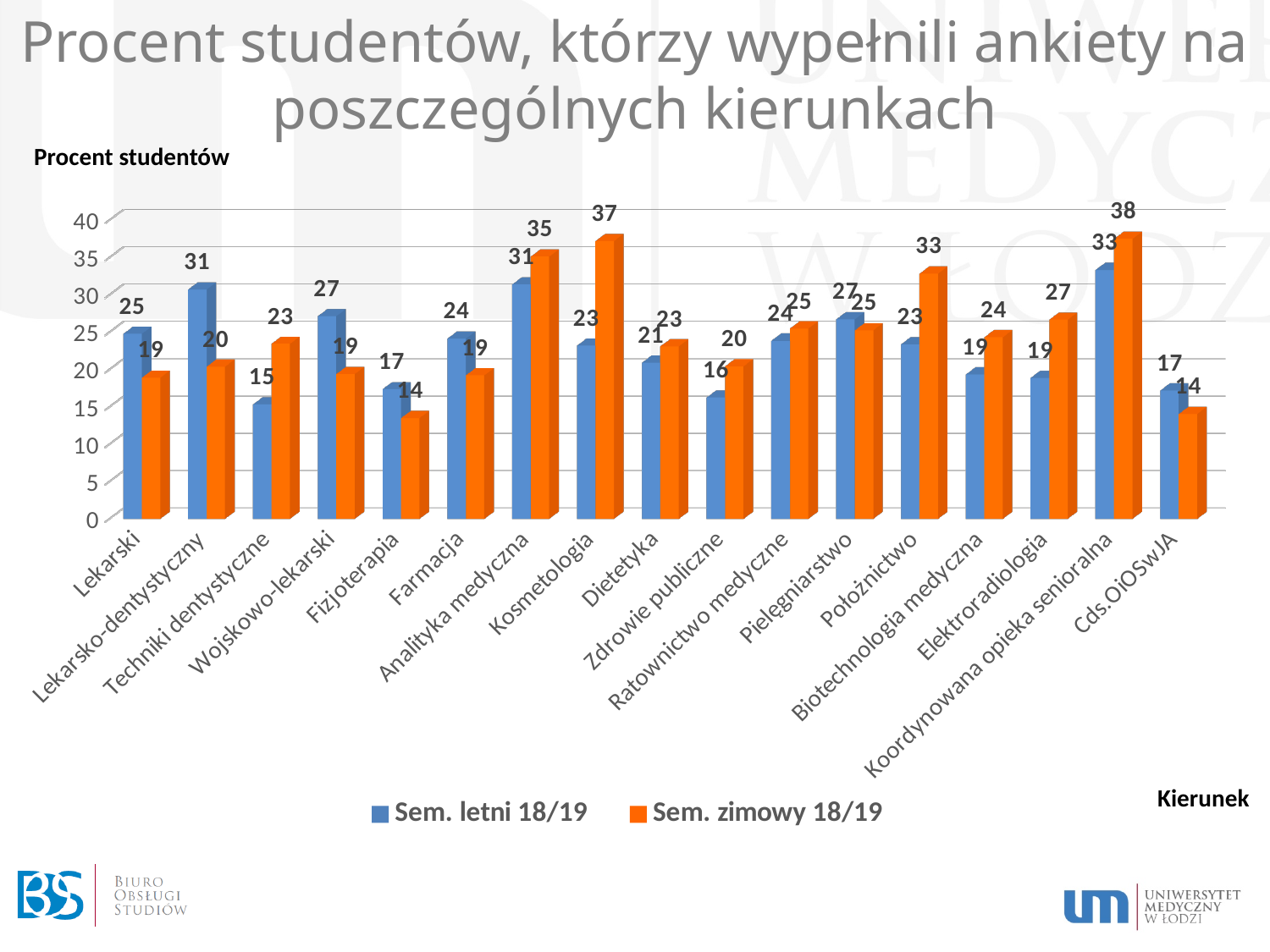
How many series does the legend list? 2 What is the Sem. zimowy 18/19 value for Kosmetologia? 37 For Położnictwo, which series has the larger value: Sem. letni 18/19 or Sem. zimowy 18/19? Sem. zimowy 18/19 How many categories (kierunki) are shown on the x axis? 17 What is the Sem. letni 18/19 value for Techniki dentystyczne? 15 What is the difference between the Sem. letni 18/19 and Sem. zimowy 18/19 values for Lekarsko-dentystyczny? 11 What is the Sem. letni 18/19 value for Lekarsko-dentystyczny? 31 Is the Sem. letni 18/19 value for Koordynowana opieka senioralna greater or less than 30? greater Which category has the lowest Sem. letni 18/19 value? Techniki dentystyczne Which category has the highest Sem. zimowy 18/19 value? Koordynowana opieka senioralna What is the difference between the Sem. zimowy 18/19 and Sem. letni 18/19 values for Kosmetologia? 14 What type of chart is shown on the slide? bar chart